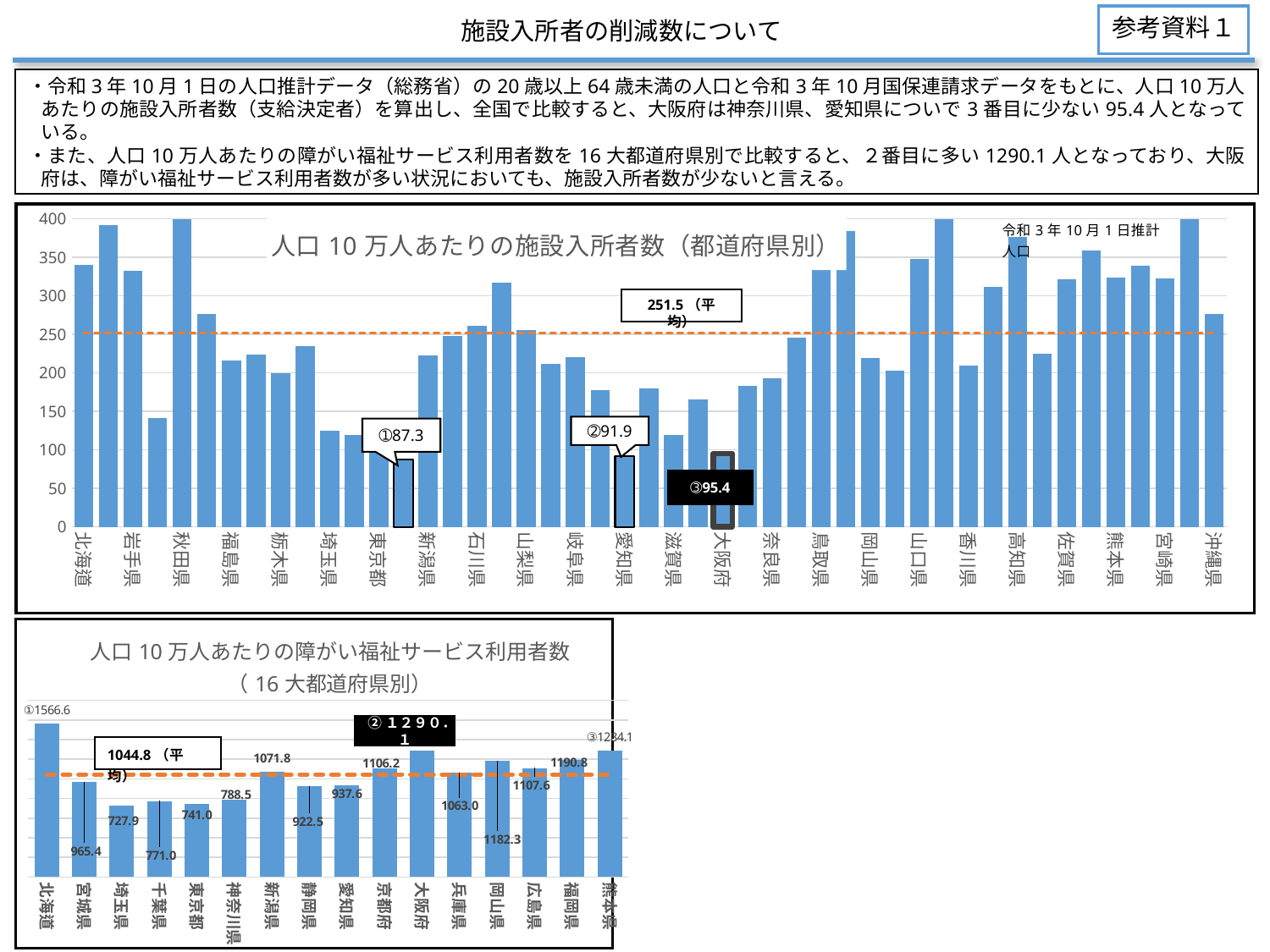
In the bottom chart (人口10万人あたりの障がい福祉サービス利用者数), what is the value for 北海道? 1566.6 What kind of chart is the bottom chart (人口10万人あたりの障がい福祉サービス利用者数)? bar chart In the bottom chart (人口10万人あたりの障がい福祉サービス利用者数), which is larger, the value for 京都府 or 兵庫県? 京都府 How many prefectures are plotted in the bottom chart (人口10万人あたりの障がい福祉サービス利用者数)? 16 In the bottom chart (人口10万人あたりの障がい福祉サービス利用者数), what is the difference between the values for 北海道 and 大阪府? 276.5 In the top chart (人口10万人あたりの施設入所者数), is the value for 滋賀県 greater or less than 150? less In the top chart (人口10万人あたりの施設入所者数), what is the value for 大阪府? 95.4 In the top chart (人口10万人あたりの施設入所者数), what average value is marked by the dashed line? 251.5 In the top chart (人口10万人あたりの施設入所者数), is the value for 北海道 greater or less than 300? greater In the bottom chart (人口10万人あたりの障がい福祉サービス利用者数), which prefecture has the lowest value? 埼玉県